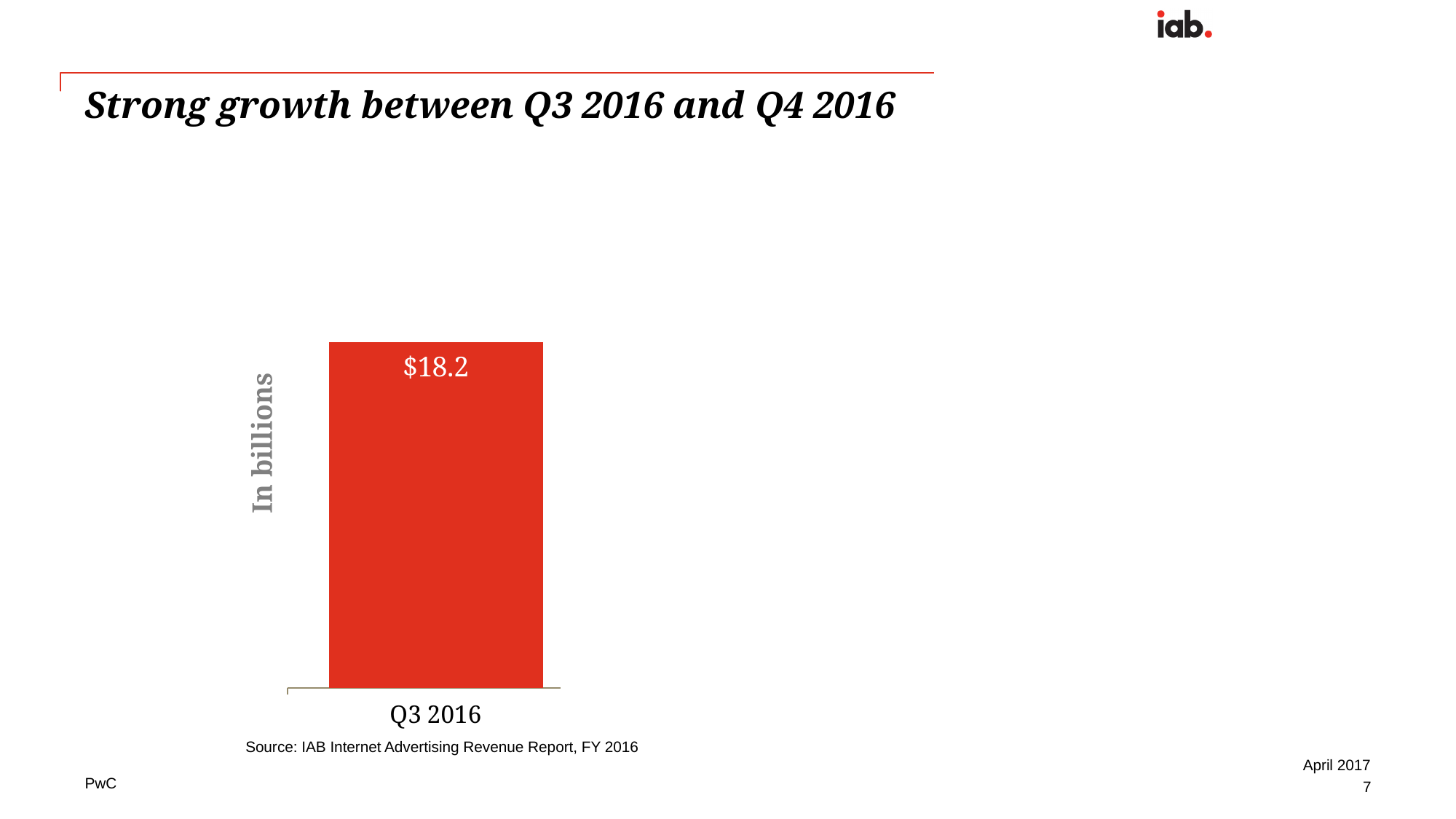
What kind of chart is shown on the slide? bar chart Which category is labelled on the x axis of the chart? Q3 2016 How many bars are plotted in the chart? 1 What colour is the bar for Q3 2016? red What is the label on the vertical axis of the chart? In billions What is the value shown for Q3 2016? $18.2